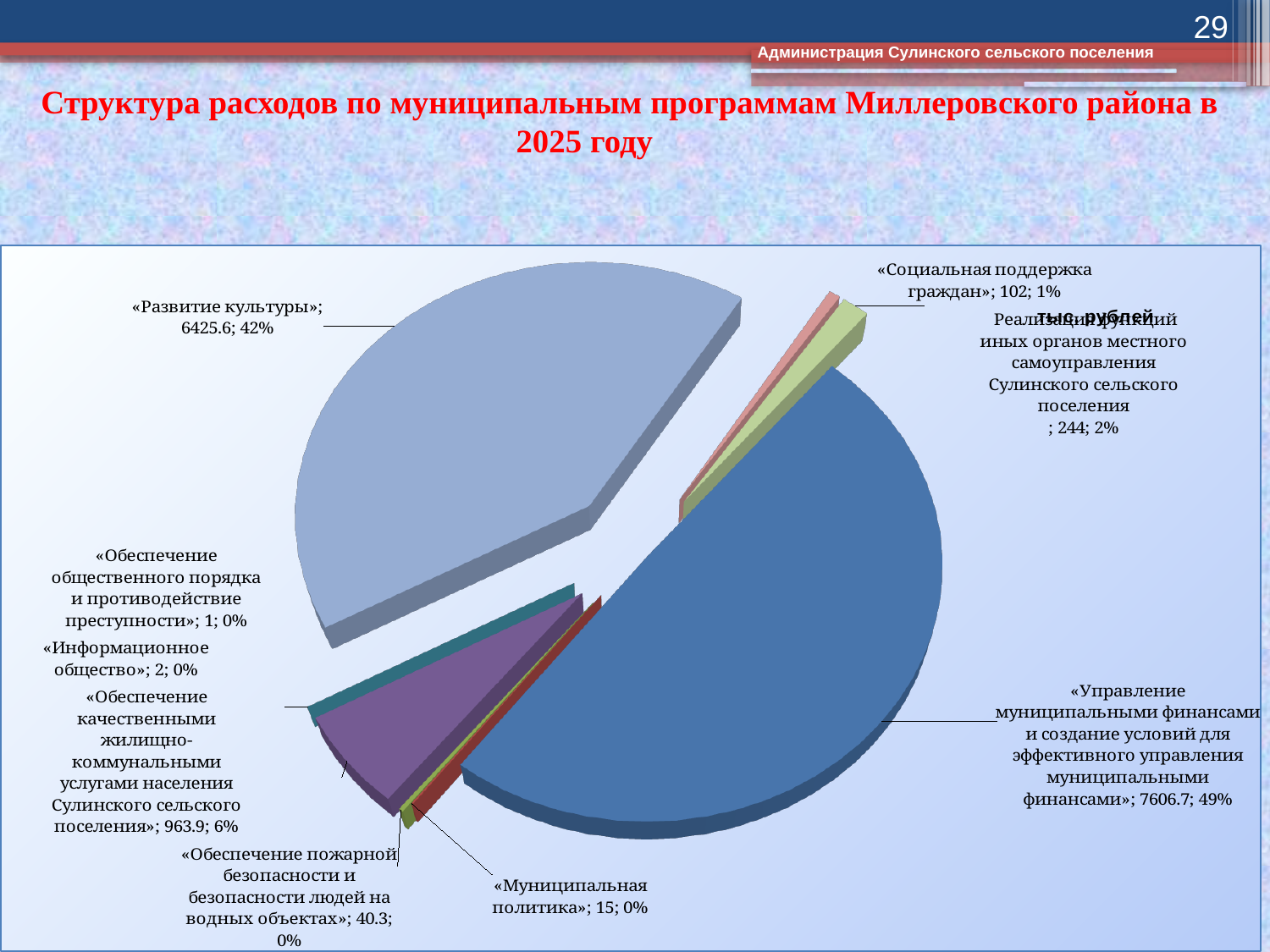
What share of the pie does «Обеспечение качественными жилищно-коммунальными услугами населения Сулинского сельского поселения» represent? 6% What is the difference between the values for «Управление муниципальными финансами...» (7606.7) and «Развитие культуры» (6425.6)? 1181.1 What is the value for «Социальная поддержка граждан»? 102 What kind of chart is shown on the slide? Pie chart Which is larger: the value for «Социальная поддержка граждан» or the value for «Муниципальная политика»? «Социальная поддержка граждан» How many slices does the pie chart have? 9 Which category has the smallest value? «Обеспечение общественного порядка и противодействие преступности» What is the value for «Развитие культуры»? 6425.6 What share of the pie does «Развитие культуры» represent? 42% What is the value for «Управление муниципальными финансами и создание условий для эффективного управления муниципальными финансами»? 7606.7 What is the value for «Обеспечение качественными жилищно-коммунальными услугами населения Сулинского сельского поселения»? 963.9 Which category has the largest slice of the pie? «Управление муниципальными финансами и создание условий для эффективного управления муниципальными финансами»